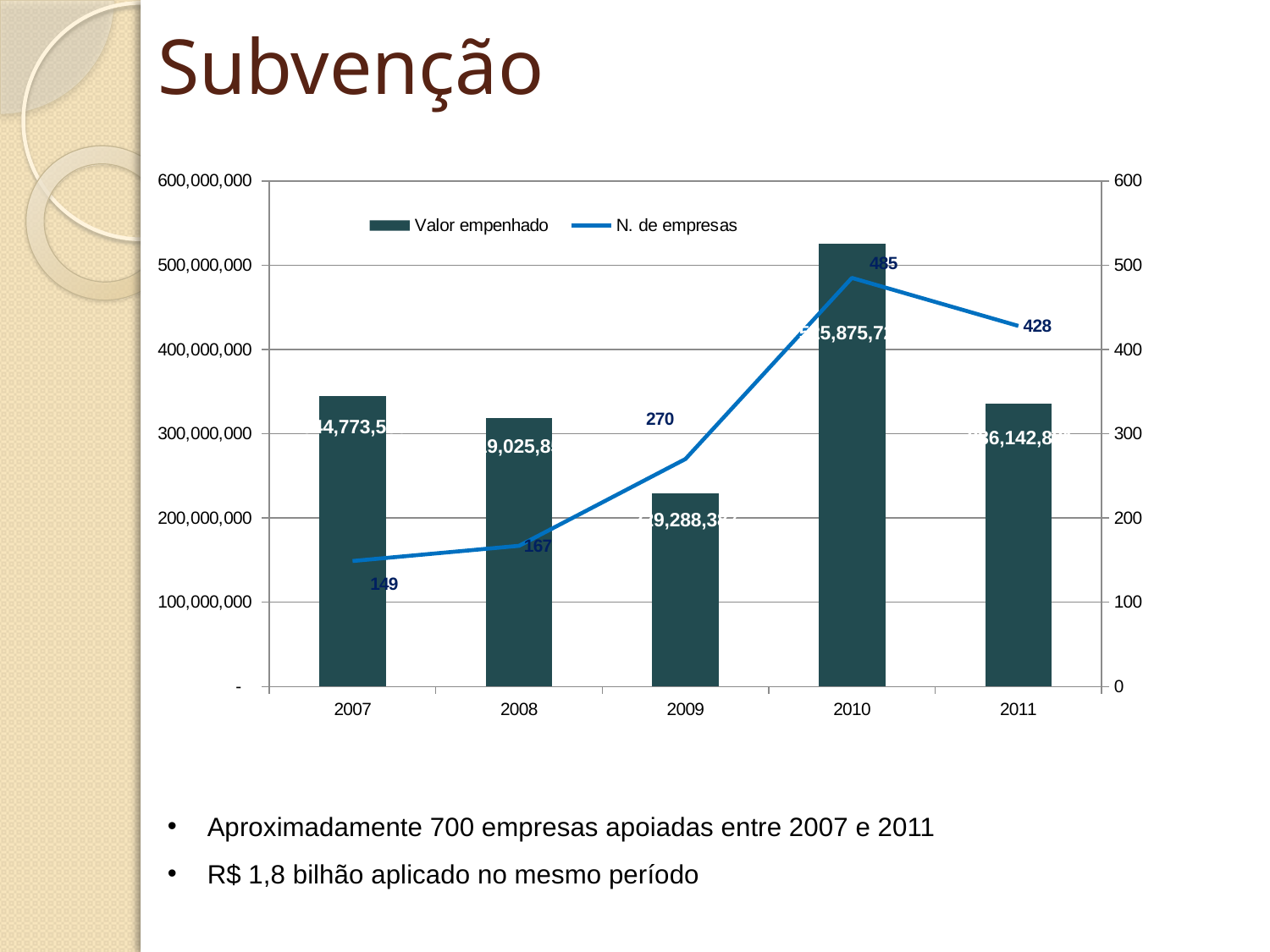
What is the value of N. de empresas for 2007? 149 What is the value of N. de empresas for 2009? 270 Is the Valor empenhado bar for 2007 greater or less than 400,000,000? less What is the value of N. de empresas for 2010? 485 In which year is the Valor empenhado bar the tallest? 2010 What is the difference in N. de empresas between 2010 and 2011? 57 How many series does the legend list? 2 Is the Valor empenhado bar for 2010 greater or less than 500,000,000? greater In which year is N. de empresas highest? 2010 In which year is N. de empresas lowest? 2007 How does N. de empresas change from 2007 to 2010? It rises In which year is the Valor empenhado bar the shortest? 2009